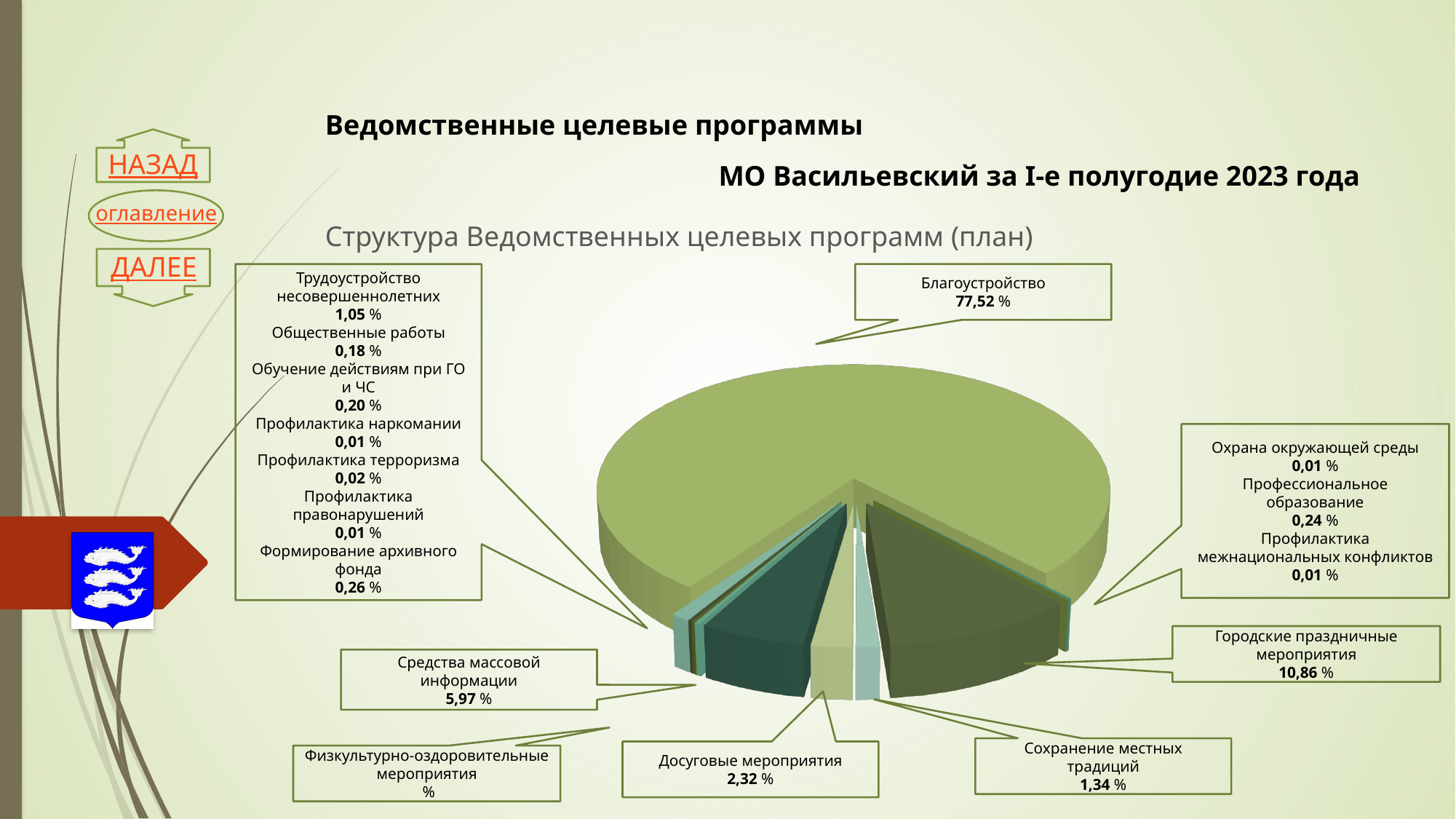
What is the value shown for Досуговые мероприятия? 2,32 % What is the value shown for Сохранение местных традиций? 1,34 % What is the value shown for Городские праздничные мероприятия? 10,86 % What is the value shown for Профессиональное образование? 0,24 % What type of chart is shown on the slide? pie chart Which category has the largest share of the pie? Благоустройство Which is larger, Городские праздничные мероприятия or Средства массовой информации? Городские праздничные мероприятия What share of the pie does Благоустройство account for? 77,52 % What is the value shown for Средства массовой информации? 5,97 % What is the difference between the values for Благоустройство and Городские праздничные мероприятия? 66,66 % What is the value shown for Формирование архивного фонда? 0,26 % What is the title of the chart? Структура Ведомственных целевых программ (план)